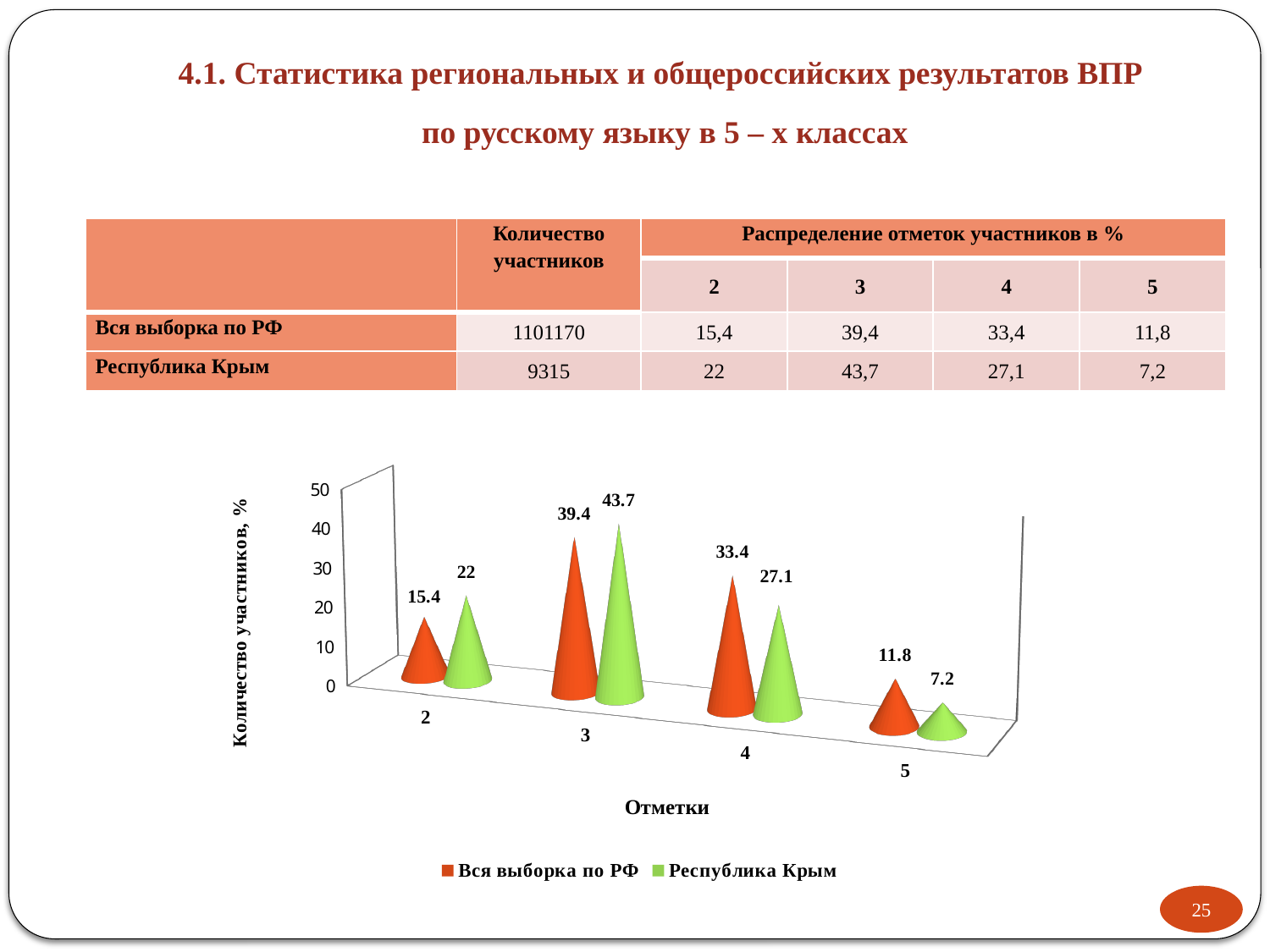
Is the value for "Вся выборка по РФ" at mark 4 greater or less than 30? greater What kind of chart is shown on the slide? bar chart How many series does the legend list? 2 Which mark has the lowest value for "Вся выборка по РФ"? 5 How many marks (categories) are shown on the x axis? 4 What is the label of the x axis? Отметки What is the value for "Республика Крым" at mark 5? 7.2 What is the value for "Вся выборка по РФ" at mark 3? 39.4 What is the difference between "Республика Крым" and "Вся выборка по РФ" at mark 3? 4.3 What is the value for "Республика Крым" at mark 2? 22 At mark 4, which series has the larger value: "Вся выборка по РФ" or "Республика Крым"? Вся выборка по РФ Which mark has the highest value for "Республика Крым"? 3